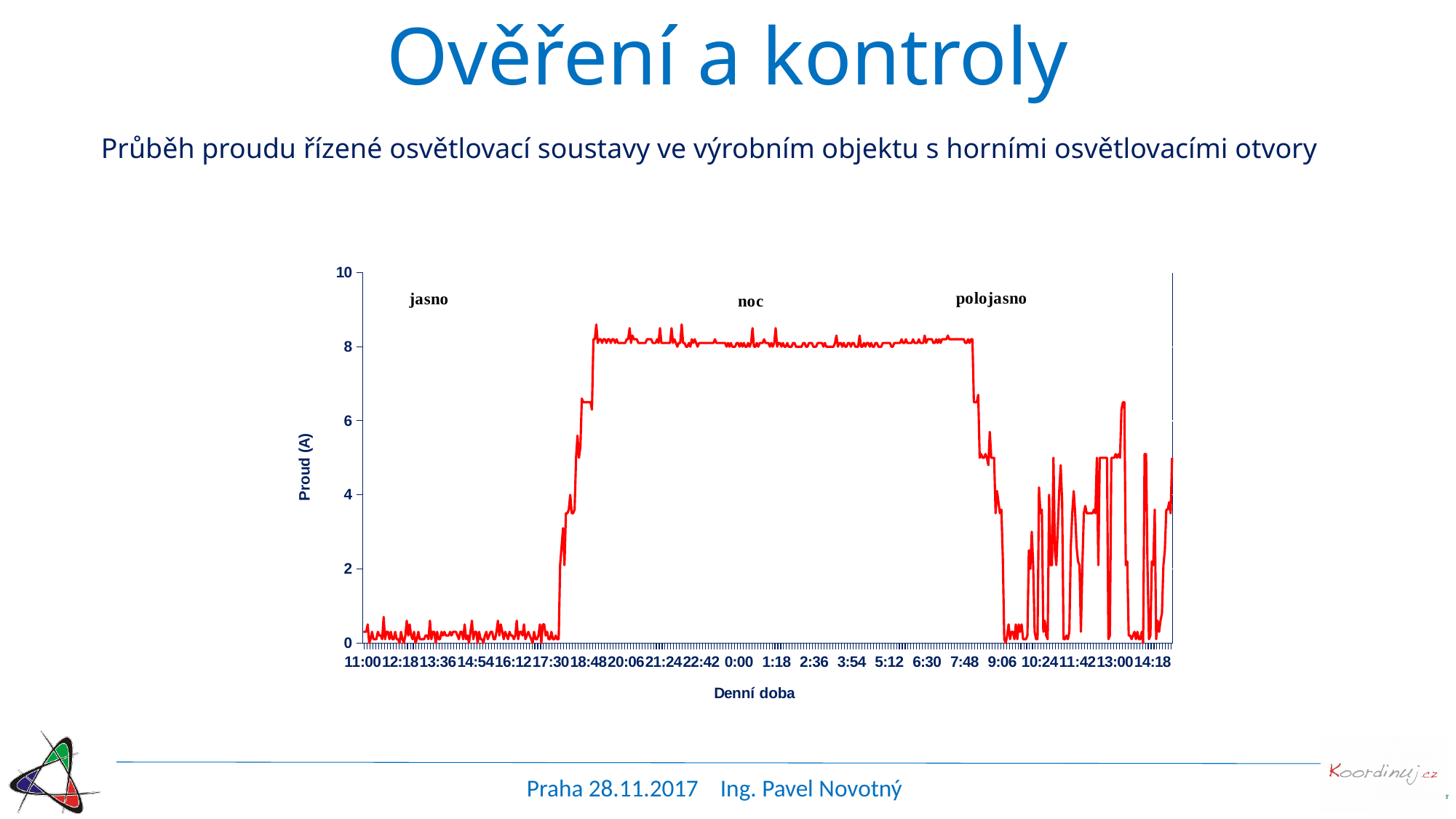
Does the current rise or fall between 17:30 and 18:48? rises Is the value of Proud (A) at 0:00 greater or less than 6? greater What is the label of the y axis? Proud (A) Is the value of Proud (A) at 12:18 greater or less than 2? less Is the current during the period labelled 'noc' higher or lower than during the period labelled 'jasno'? higher Is the value of Proud (A) at 5:12 greater or less than 4? greater Does the current rise or fall between 7:48 and 9:06? falls What kind of chart is shown on the slide? line chart What is the label of the x axis? Denní doba